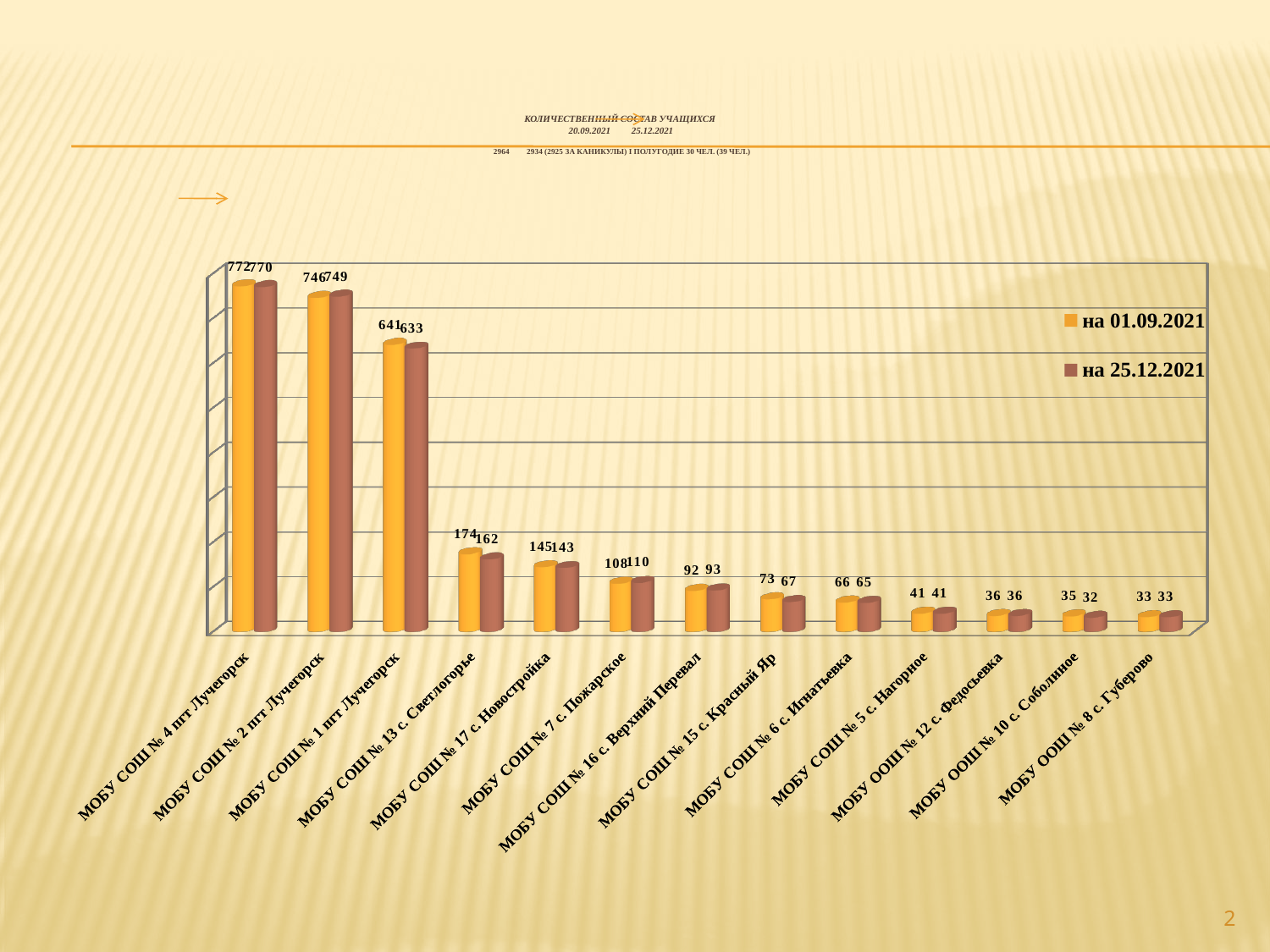
What kind of chart is shown on the slide? bar chart What is the value for МОБУ СОШ № 15 с. Красный Яр in the series 'на 25.12.2021'? 67 How many series does the legend list? 2 What is the value for МОБУ СОШ № 13 с. Светлогорье in the series 'на 25.12.2021'? 162 Do the values in the series 'на 01.09.2021' rise or fall from left to right along the x axis? fall Which school has the highest value in the series 'на 01.09.2021'? МОБУ СОШ № 4 пгт Лучегорск What are the two legend entries of the chart? на 01.09.2021 and на 25.12.2021 What is the value for МОБУ СОШ № 4 пгт Лучегорск in the series 'на 01.09.2021'? 772 What is the difference between the 'на 01.09.2021' and 'на 25.12.2021' values for МОБУ СОШ № 13 с. Светлогорье? 12 For МОБУ СОШ № 2 пгт Лучегорск, which series has the larger value: 'на 01.09.2021' or 'на 25.12.2021'? на 25.12.2021 How many schools (categories) are shown on the x axis? 13 Which school has the lowest value in the series 'на 25.12.2021'? МОБУ ООШ № 10 с. Соболиное